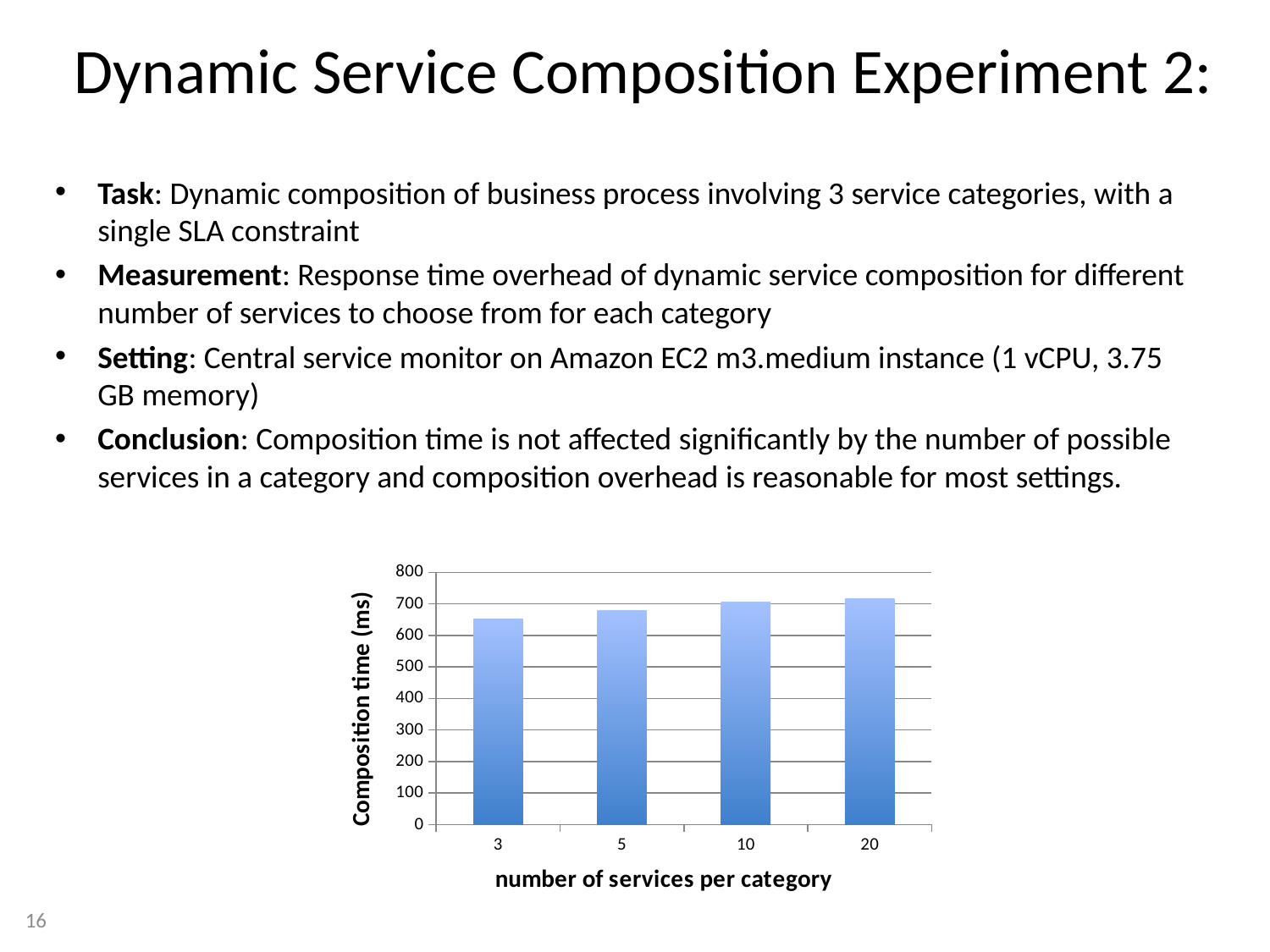
Do the composition times rise or fall as the number of services per category increases from 3 to 20? rise Is the composition time for 5 services per category greater or less than 700? less Is the composition time for 3 services per category greater or less than 600? greater What kind of chart is shown on the slide? bar chart Which number of services per category has the lowest composition time? 3 What is the title of the chart's x axis? number of services per category Is the composition time for 20 services per category greater or less than 700? greater What is the title of the chart's y axis? Composition time (ms) Which has the larger composition time: 3 services per category or 20 services per category? 20 Which has the larger composition time: 3 services per category or 10 services per category? 10 How many bars (categories) are plotted in the chart? 4